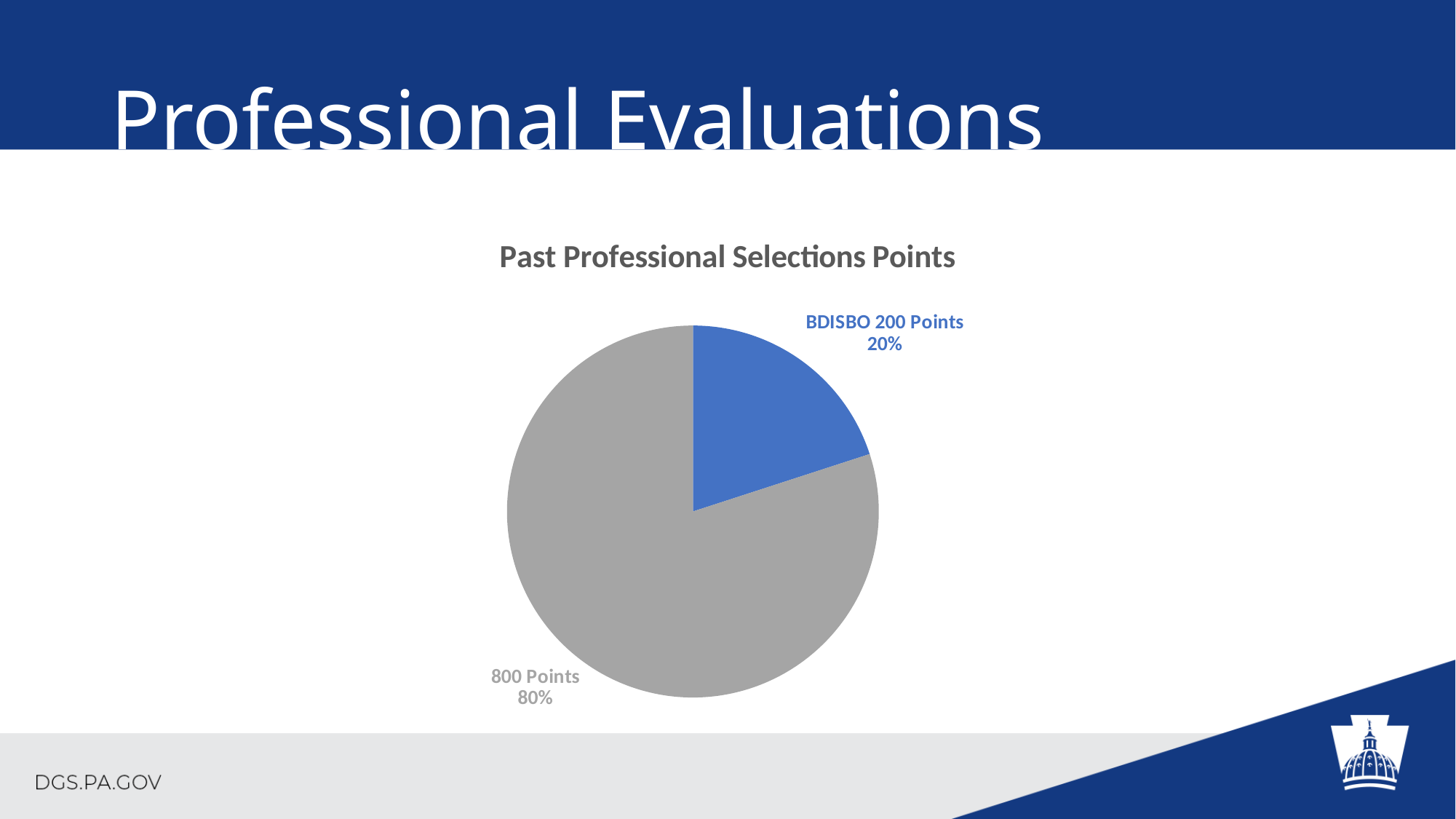
What is the title of the chart? Past Professional Selections Points What kind of chart is shown on the slide? pie chart Which is larger, the BDISBO slice or the 800 Points slice? 800 Points What is the difference in points between the 800 Points slice and the BDISBO slice? 600 Points What share of the pie does the BDISBO slice represent? 20% What colour is the BDISBO slice? blue How many points does the BDISBO slice represent? 200 Points How many slices does the pie chart have? 2 What share of the pie does the 800 Points slice represent? 80% Which slice is the largest in the pie chart? 800 Points Which slice is the smallest in the pie chart? BDISBO 200 Points How many points does the grey slice represent? 800 Points